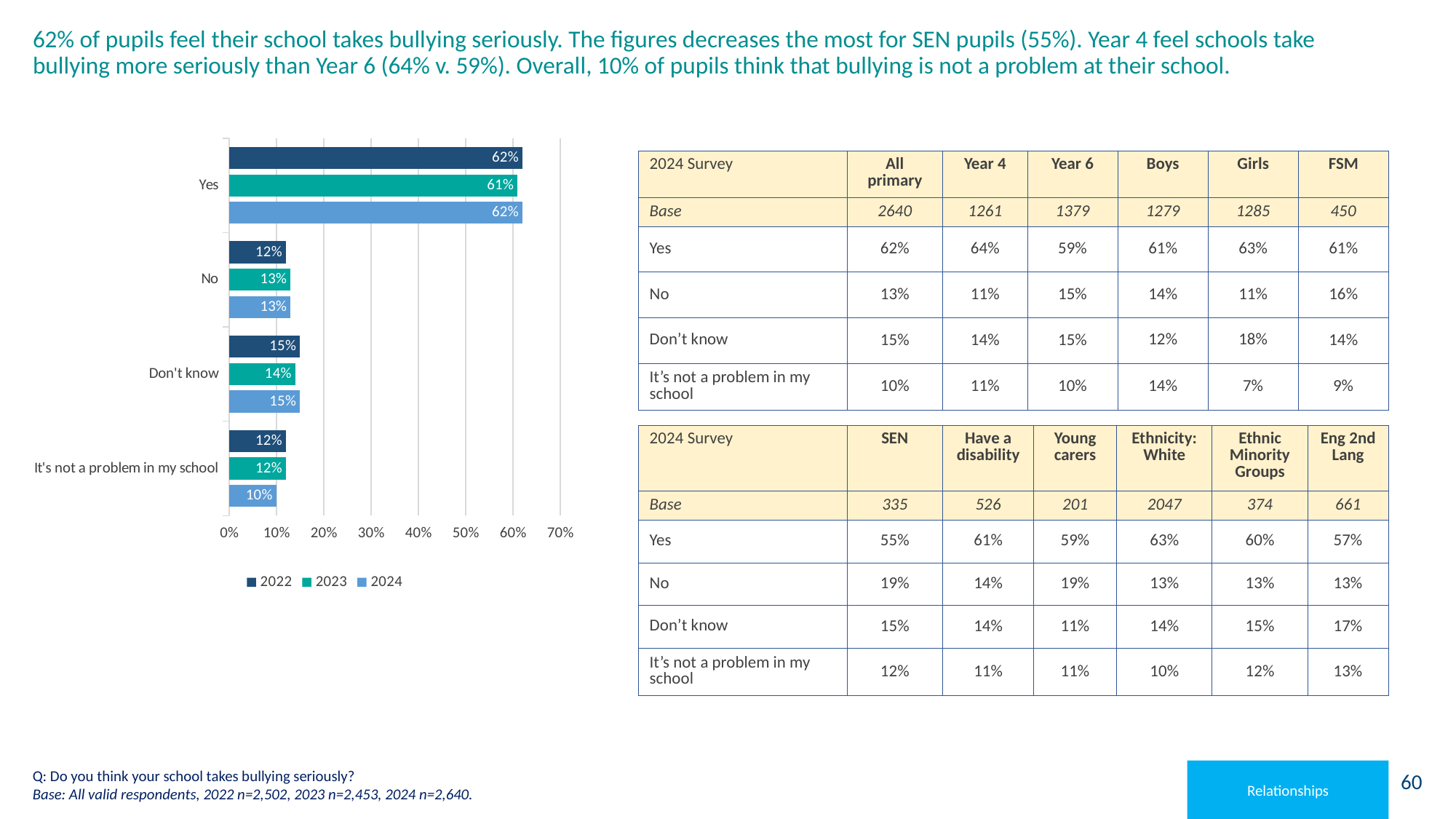
How many series does the chart legend list? 3 Which response category has the highest value for 2024 in the chart? Yes What is the 2024 value for 'Yes' in the chart? 62% What kind of chart is shown on the slide? bar chart Which years are listed in the chart legend? 2022, 2023, 2024 Is the 2022 value for 'Don't know' larger or smaller than the 2023 value for 'Don't know' in the chart? larger What is the difference between the 2022 and 2024 values for 'It's not a problem in my school' in the chart? 2% What is the 2023 value for 'Don't know' in the chart? 14% What is the 2022 value for 'No' in the chart? 12% What is the 2024 value for 'It's not a problem in my school' in the chart? 10% How many response categories are shown on the chart? 4 Which response category has the lowest value for 2024 in the chart? It's not a problem in my school